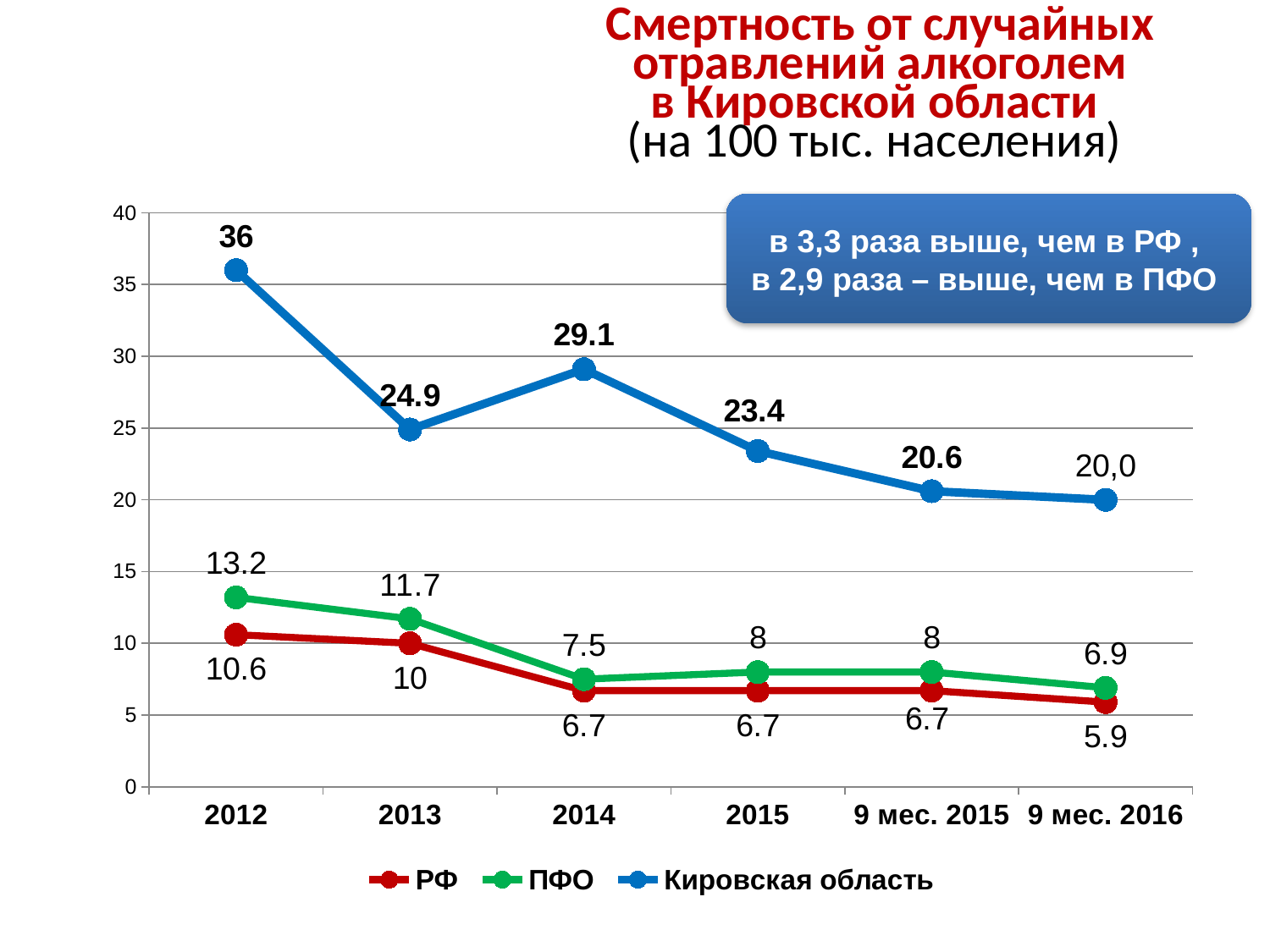
Which is larger in 2015: the value for ПФО or the value for РФ? ПФО What is the value for РФ in 9 мес. 2016? 5.9 In which year or period is the value for Кировская область highest? 2012 How many categories are shown on the x axis? 6 In which year or period is the value for РФ lowest? 9 мес. 2016 What is the value for ПФО in 2013? 11.7 What kind of chart is shown on the slide? Line chart What is the difference between the Кировская область value and the РФ value in 2014? 22.4 How many series does the legend list? 3 What is the value for Кировская область in 2012? 36 What is the value for Кировская область in 9 мес. 2016? 20,0 Does the value for ПФО generally rise or fall from 2012 to 9 мес. 2016? Fall